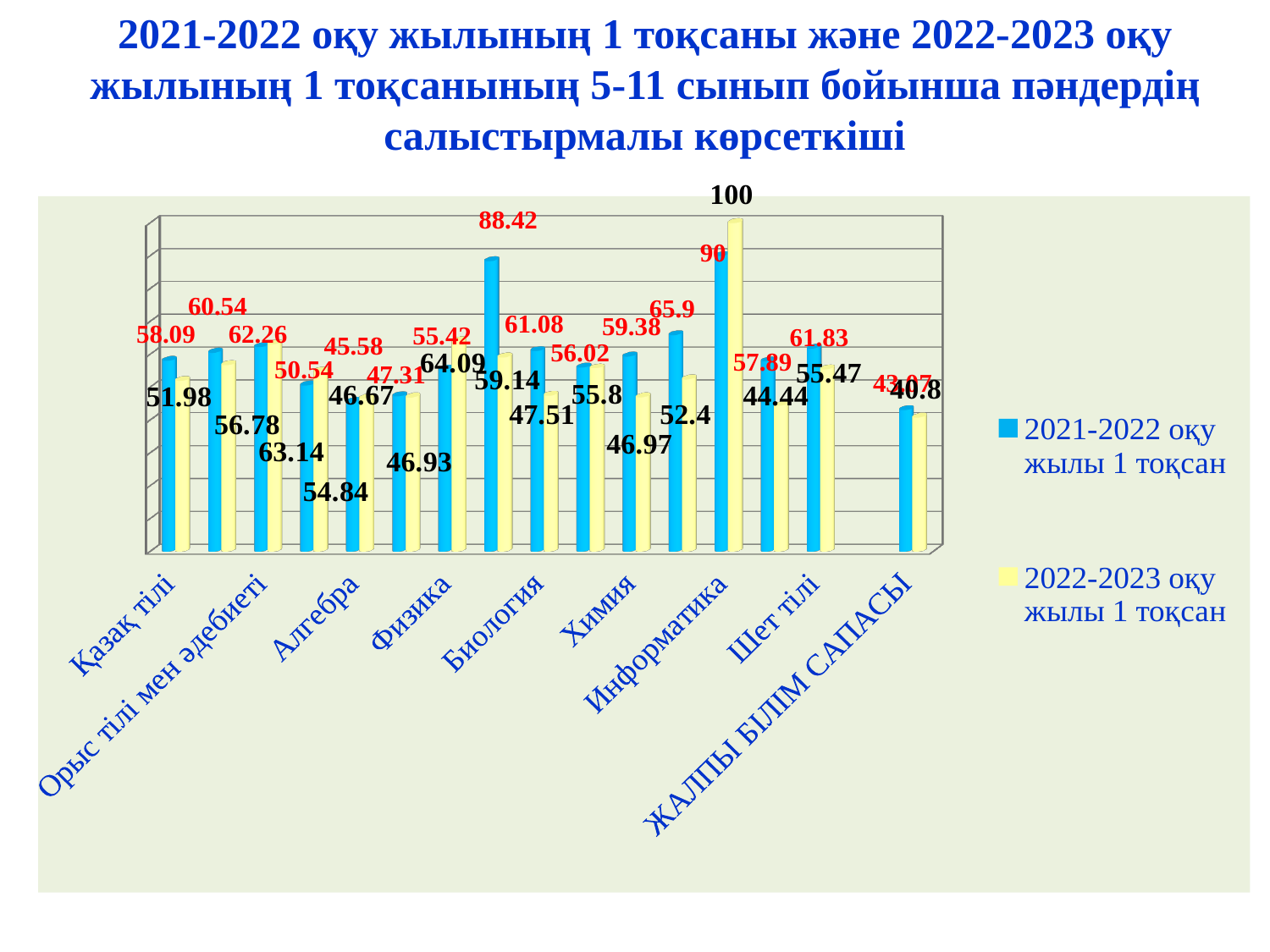
Which colour represents the 2022-2023 оқу жылы 1 тоқсан series? yellow What kind of chart is shown on the slide? bar chart What is the difference between the 2021-2022 and 2022-2023 values for ЖАЛПЫ БІЛІМ САПАСЫ? 2.27 What is the highest value shown for the 2022-2023 оқу жылы 1 тоқсан series? 100 For ЖАЛПЫ БІЛІМ САПАСЫ, which series has the larger value, 2021-2022 оқу жылы 1 тоқсан or 2022-2023 оқу жылы 1 тоқсан? 2021-2022 оқу жылы 1 тоқсан What is the value for ЖАЛПЫ БІЛІМ САПАСЫ in the 2022-2023 оқу жылы 1 тоқсан series? 40.8 What is the highest value shown for the 2021-2022 оқу жылы 1 тоқсан series? 90 What are the two series named in the legend? 2021-2022 оқу жылы 1 тоқсан and 2022-2023 оқу жылы 1 тоқсан How many series does the legend list? 2 What is the lowest value shown for the 2022-2023 оқу жылы 1 тоқсан series? 40.8 What is the value for ЖАЛПЫ БІЛІМ САПАСЫ in the 2021-2022 оқу жылы 1 тоқсан series? 43.07 What is the lowest value shown for the 2021-2022 оқу жылы 1 тоқсан series? 43.07